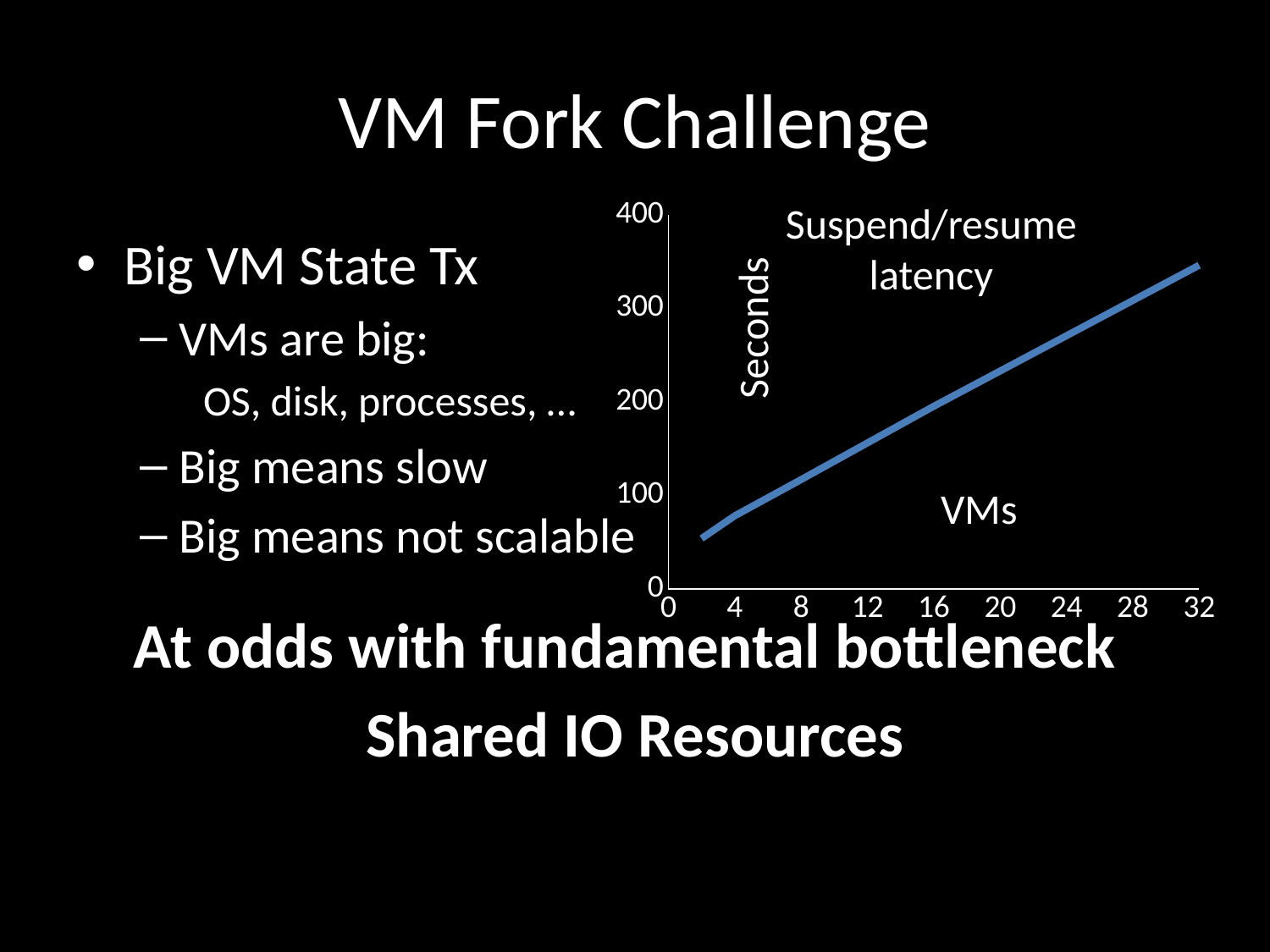
Is the suspend/resume latency at 24 VMs greater or less than 300 seconds? less Which has the higher suspend/resume latency, 8 VMs or 28 VMs? 28 VMs What is the label of the vertical axis of the chart? Seconds What is the highest value shown on the x axis of the chart? 32 What kind of chart is shown on the slide? line chart Is the suspend/resume latency at 12 VMs greater or less than 200 seconds? less Is the suspend/resume latency at 24 VMs greater or less than 200 seconds? greater Does the suspend/resume latency rise or fall as the number of VMs increases? rise What is the title of the chart? Suspend/resume latency What is the highest value shown on the y axis of the chart? 400